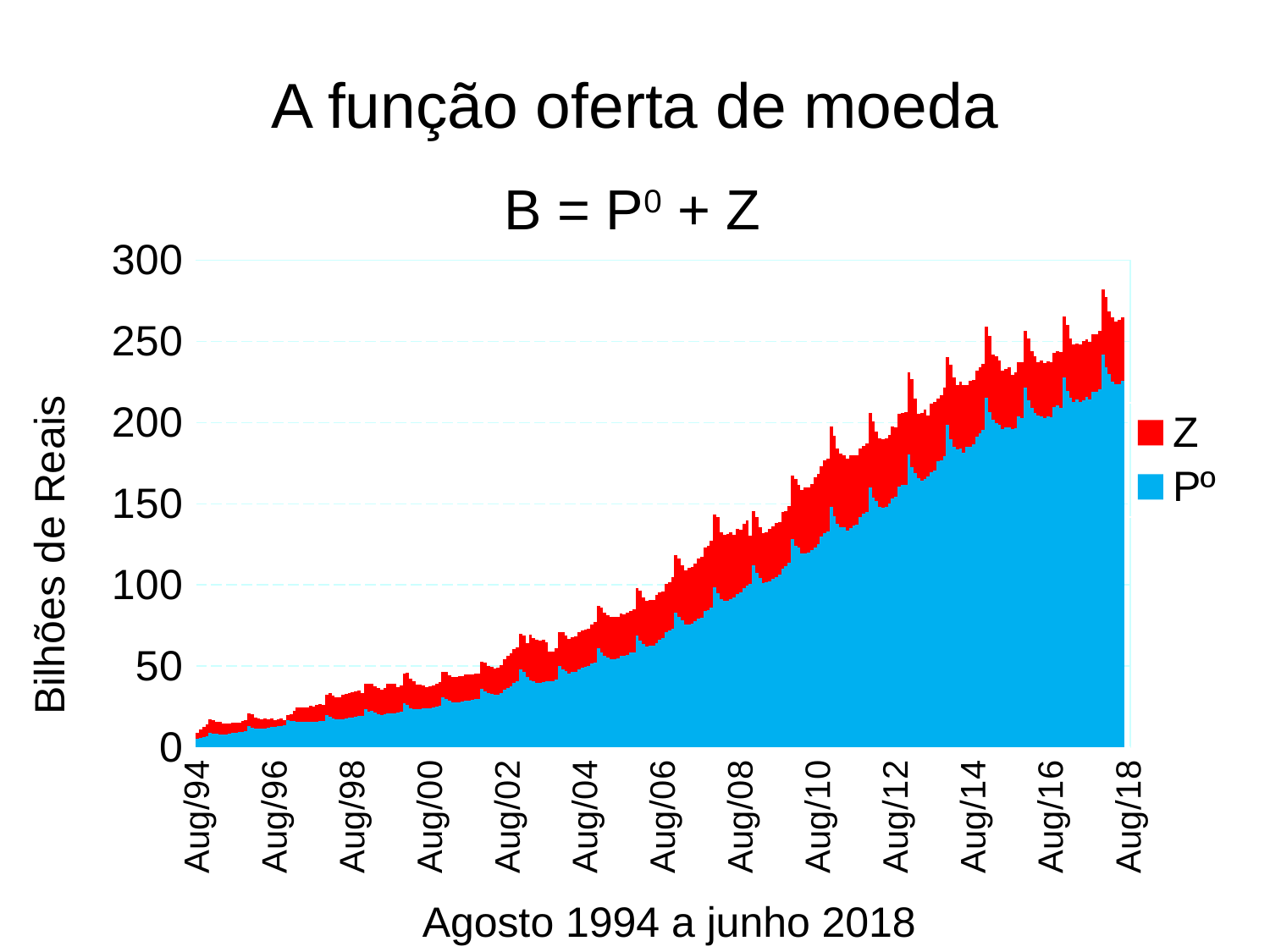
Is the value of Pº at Aug/06 greater or less than 50? greater Which series contributes the larger part of the stack, Pº or Z? Pº Is the total stacked value at Aug/10 greater or less than 150? greater What is the label on the vertical axis? Bilhões de Reais What are the two series named in the legend? Z and Pº Is the value of Pº at Aug/10 greater or less than 100? greater Do the stacked values rise or fall from Aug/94 to Aug/18? rise How many series does the legend list? 2